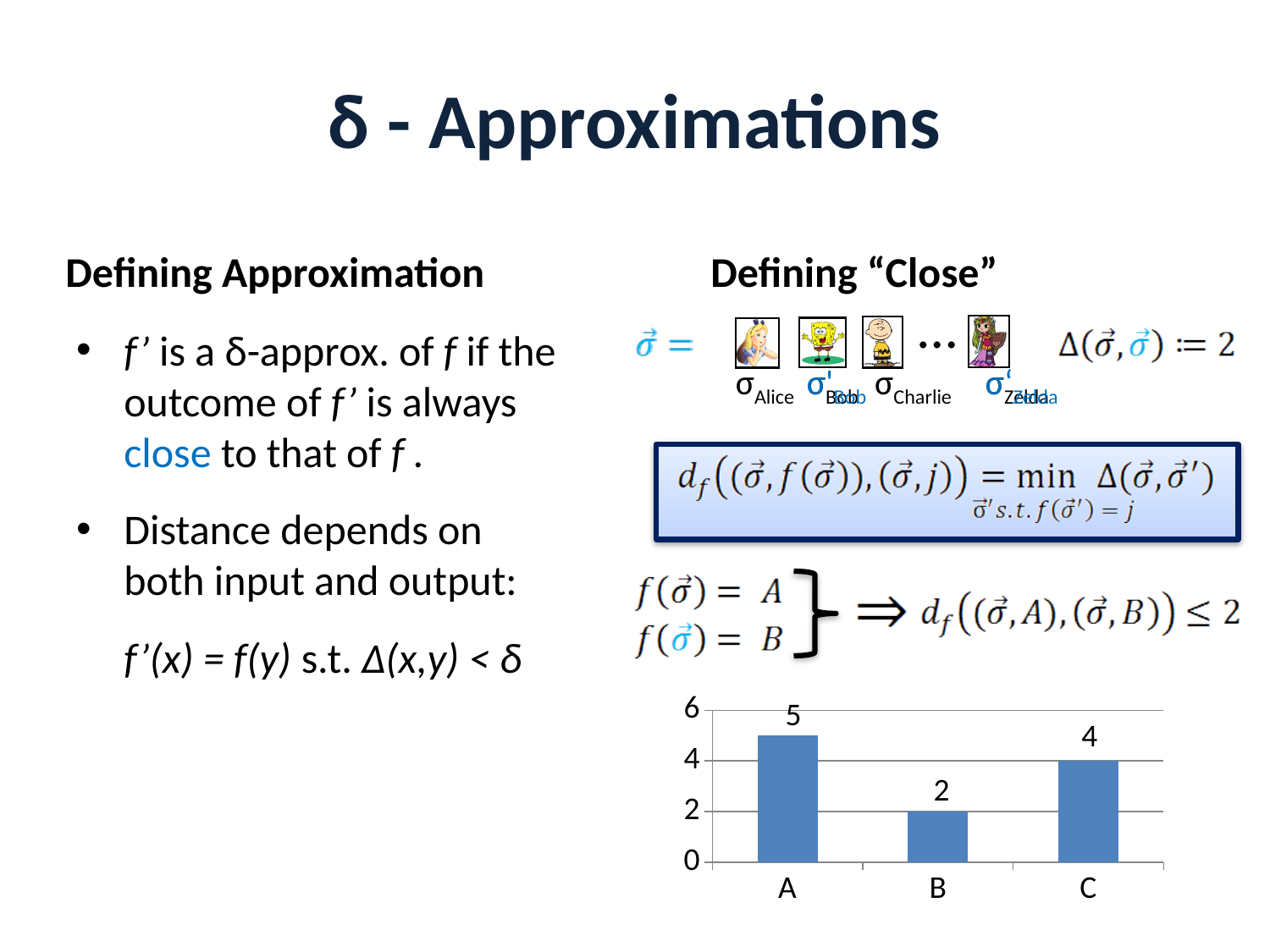
Which category has the highest value in the bar chart? A How many categories are shown in the bar chart? 3 What is the value for category C in the bar chart? 4 What is the difference between the values for A and B in the bar chart? 3 What is the value for category A in the bar chart? 5 Is the value for C in the bar chart greater or less than 2? greater Which is larger in the bar chart, the value for A or the value for C? A Which category has the lowest value in the bar chart? B What is the difference between the values for C and B in the bar chart? 2 What is the value for category B in the bar chart? 2 What is the maximum value shown on the vertical axis of the bar chart? 6 What kind of chart is shown at the bottom right of the slide? bar chart